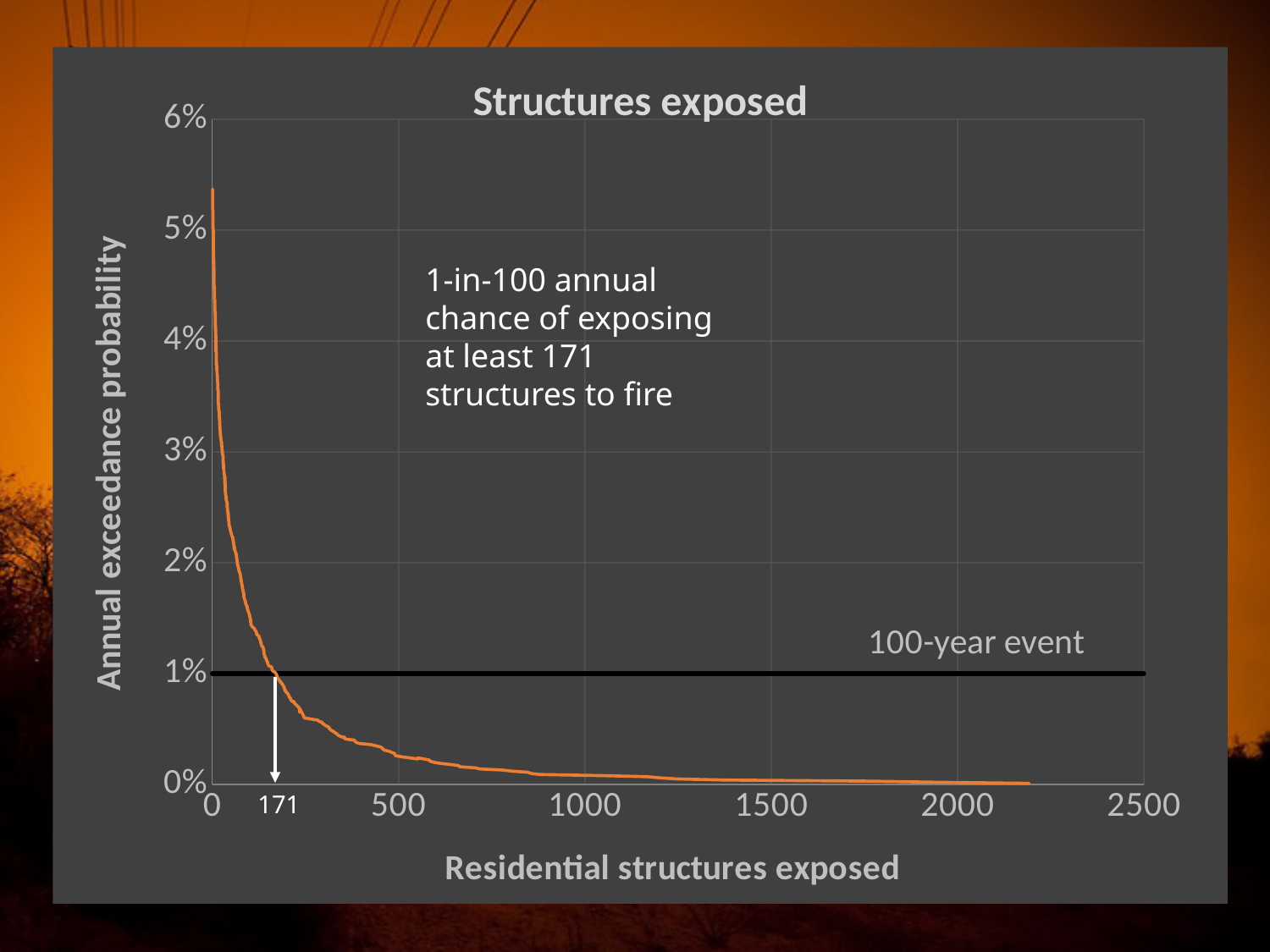
What is the highest value shown on the x axis? 2500 At what number of residential structures exposed does the curve cross the 100-year event line? 171 Is the annual exceedance probability at 1000 residential structures exposed greater or less than 1%? less What is the highest value shown on the y axis? 6% Is the annual exceedance probability at 100 residential structures exposed greater or less than 1%? greater What kind of chart is shown on the slide? line chart What is the title of the chart? Structures exposed What is the label of the x axis? Residential structures exposed Is the annual exceedance probability at the left end of the curve (near 0 structures) greater or less than 5%? greater What annual exceedance probability does the 100-year event line correspond to? 1% Does the annual exceedance probability rise or fall as the number of residential structures exposed increases? fall